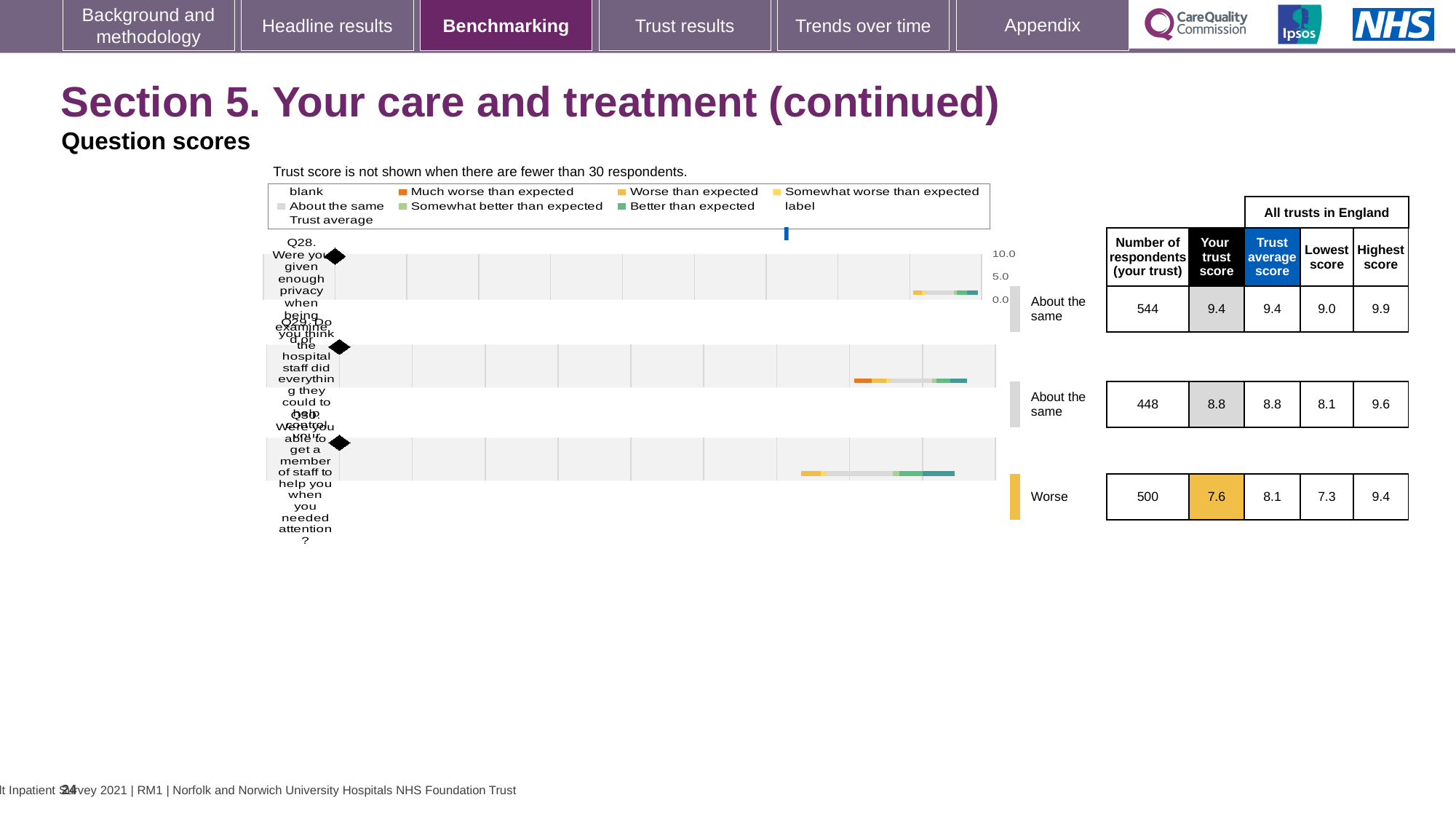
What kind of chart is used to show the question scores on this slide? bar chart Which question has the highest 'Your trust score'? Q28 How many respondents does the table show for Q30? 500 Which has the larger highest score across all trusts in England: Q28 or Q29? Q28 What is the lowest score across all trusts in England for Q29? 8.1 According to the note above the chart, when is a trust score not shown? When there are fewer than 30 respondents For Q30, what is the difference between the trust average score and your trust score? 0.5 What benchmark category label is shown next to Q30? Worse Which question has the lowest 'Your trust score'? Q30 For Q28, what is the difference between the highest score and the lowest score across all trusts in England? 0.9 What is the 'Your trust score' for Q28? 9.4 How many questions (categories) are plotted in the question scores chart? 3